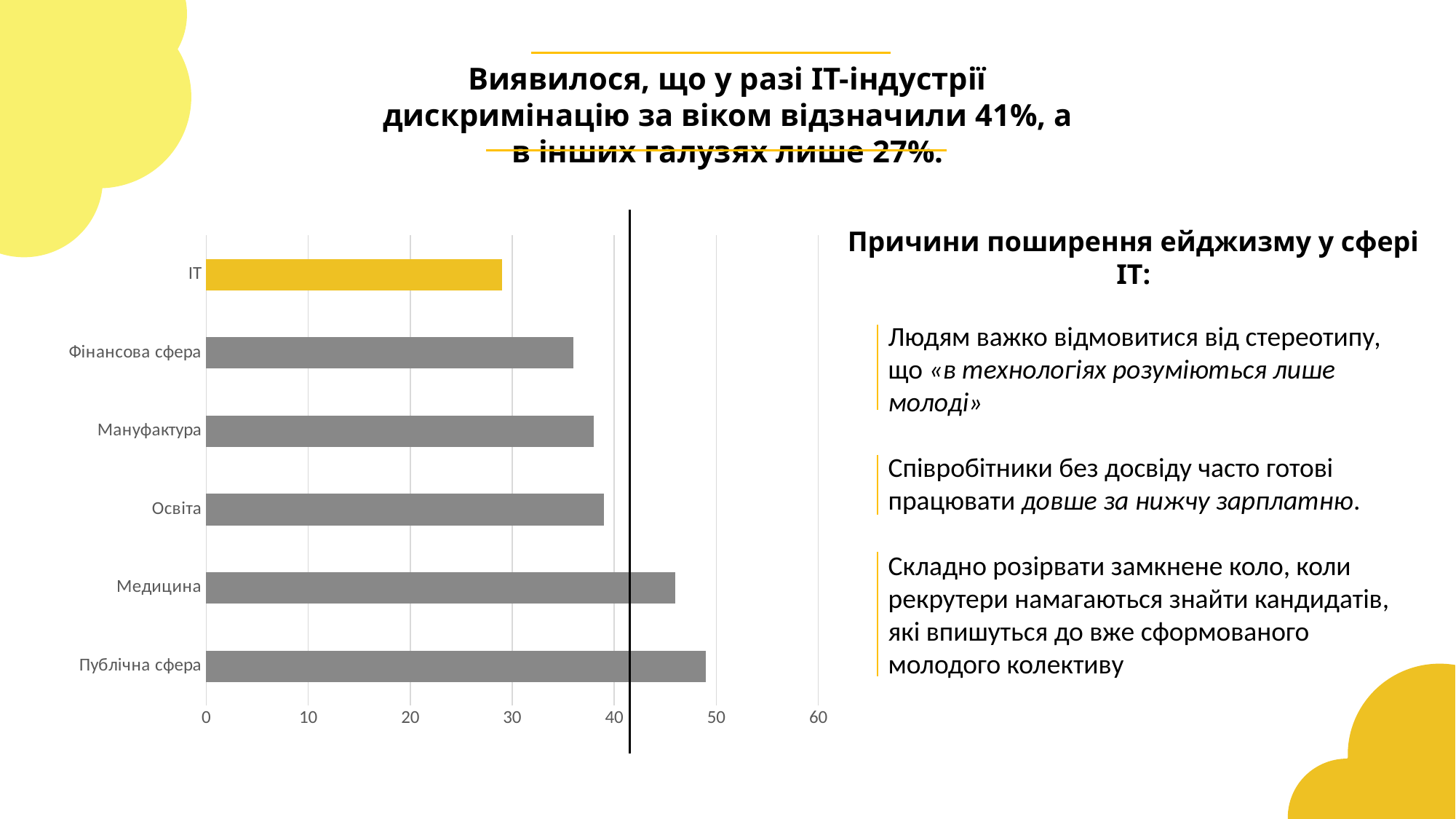
Which category's bar is coloured yellow instead of grey? IT Is the value for Медицина greater or less than 50? less What kind of chart is shown on the slide? bar chart How many categories are plotted in the bar chart? 6 Which is larger, the value for Медицина or the value for Фінансова сфера? Медицина Is the value for Фінансова сфера greater or less than 30? greater Which category has the longest bar in the chart? Публічна сфера Is the value for IT greater or less than 40? less Which category has the shortest bar in the chart? IT Which is larger, the value for IT or the value for Публічна сфера? Публічна сфера